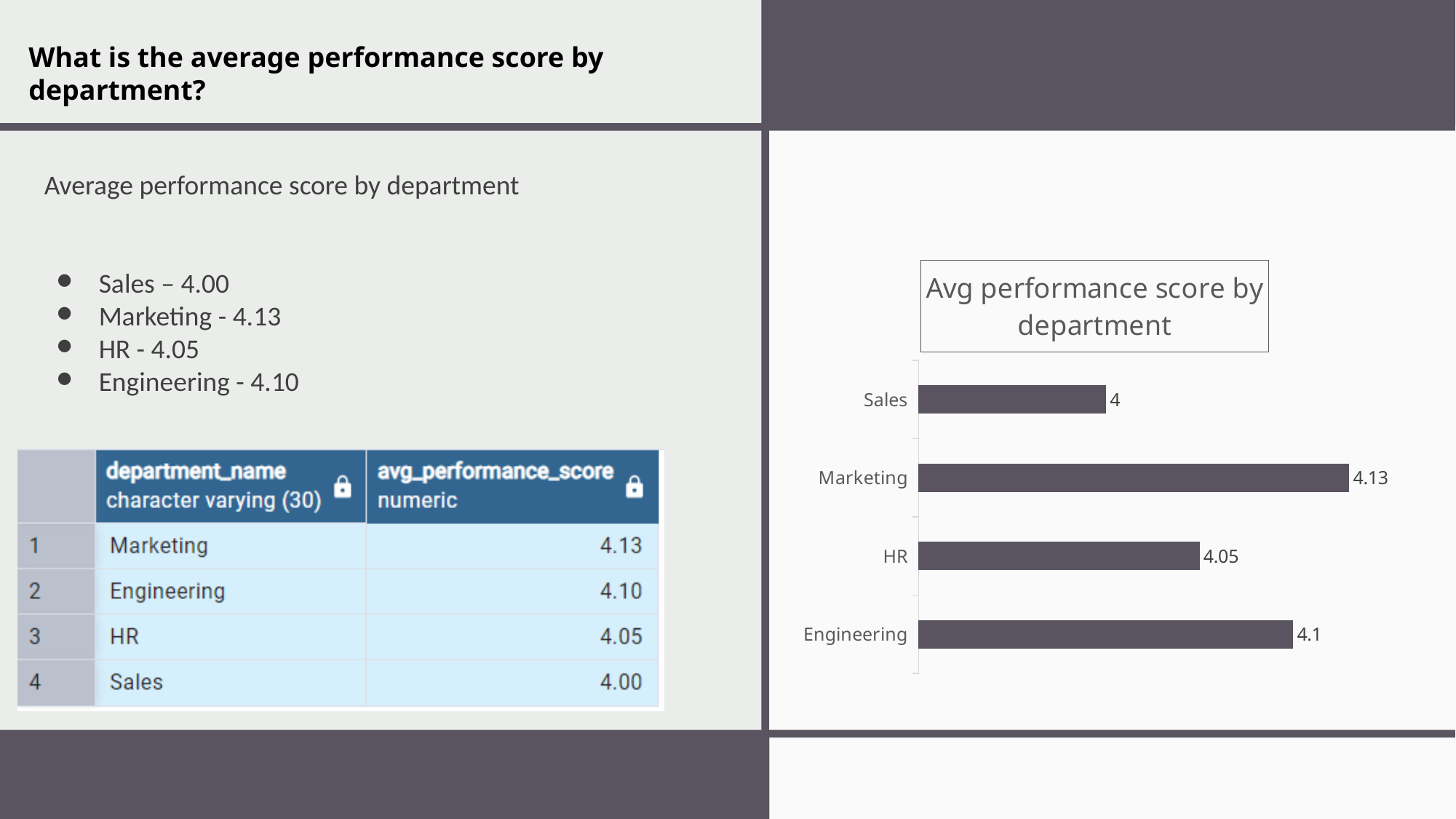
Which department has the lowest average performance score in the chart? Sales How many departments are plotted in the chart? 4 What is the difference between the Engineering and HR values in the chart? 0.05 Which department has the highest average performance score in the chart? Marketing What is the title of the chart? Avg performance score by department What is the value shown for HR in the chart? 4.05 What type of chart is shown on the slide? bar chart What is the difference between the Marketing and Sales values in the chart? 0.13 What is the value shown for Sales in the chart? 4 Which has a larger value in the chart, HR or Engineering? Engineering What is the value shown for Engineering in the chart? 4.1 What is the value shown for Marketing in the chart? 4.13